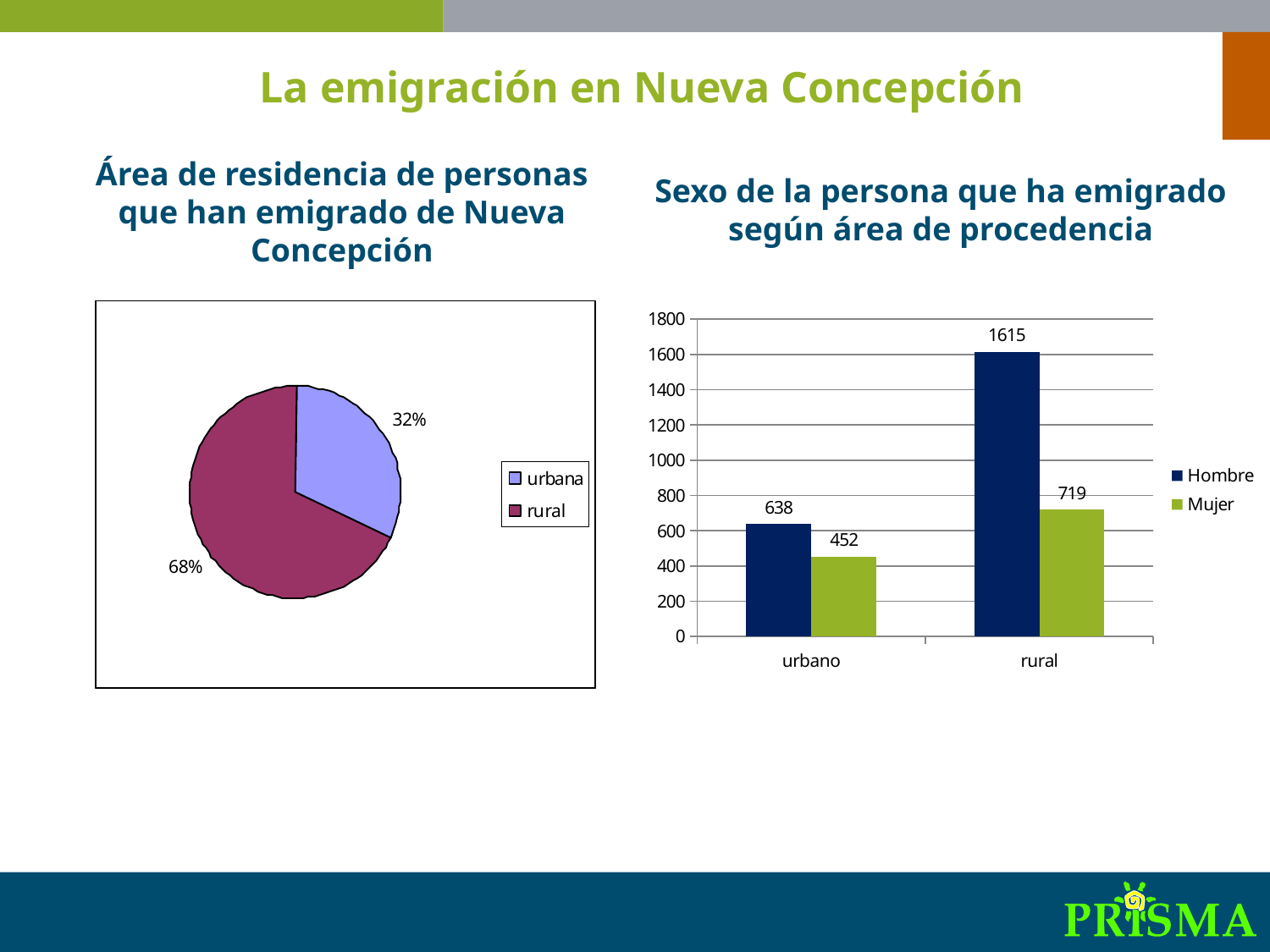
How many series does the legend of the chart 'Sexo de la persona que ha emigrado según área de procedencia' list? 2 In the chart 'Sexo de la persona que ha emigrado según área de procedencia', what is the difference between 'Hombre' and 'Mujer' in 'rural'? 896 In the pie chart 'Área de residencia de personas que han emigrado de Nueva Concepción', what share is labelled for 'rural'? 68% In the chart 'Sexo de la persona que ha emigrado según área de procedencia', what is the value for 'Mujer' in 'urbano'? 452 In the pie chart on the left, which slice is larger, 'urbana' or 'rural'? rural In the chart 'Sexo de la persona que ha emigrado según área de procedencia', what is the value for 'Hombre' in 'rural'? 1615 How many slices does the pie chart on the left have? 2 In the pie chart 'Área de residencia de personas que han emigrado de Nueva Concepción', what share is labelled for 'urbana'? 32% In the chart 'Sexo de la persona que ha emigrado según área de procedencia', what is the difference between 'Hombre' and 'Mujer' in 'urbano'? 186 In the chart 'Sexo de la persona que ha emigrado según área de procedencia', which bar is the highest? Hombre, rural What kind of chart is the chart on the left of the slide? pie chart What kind of chart is the chart on the right of the slide? bar chart